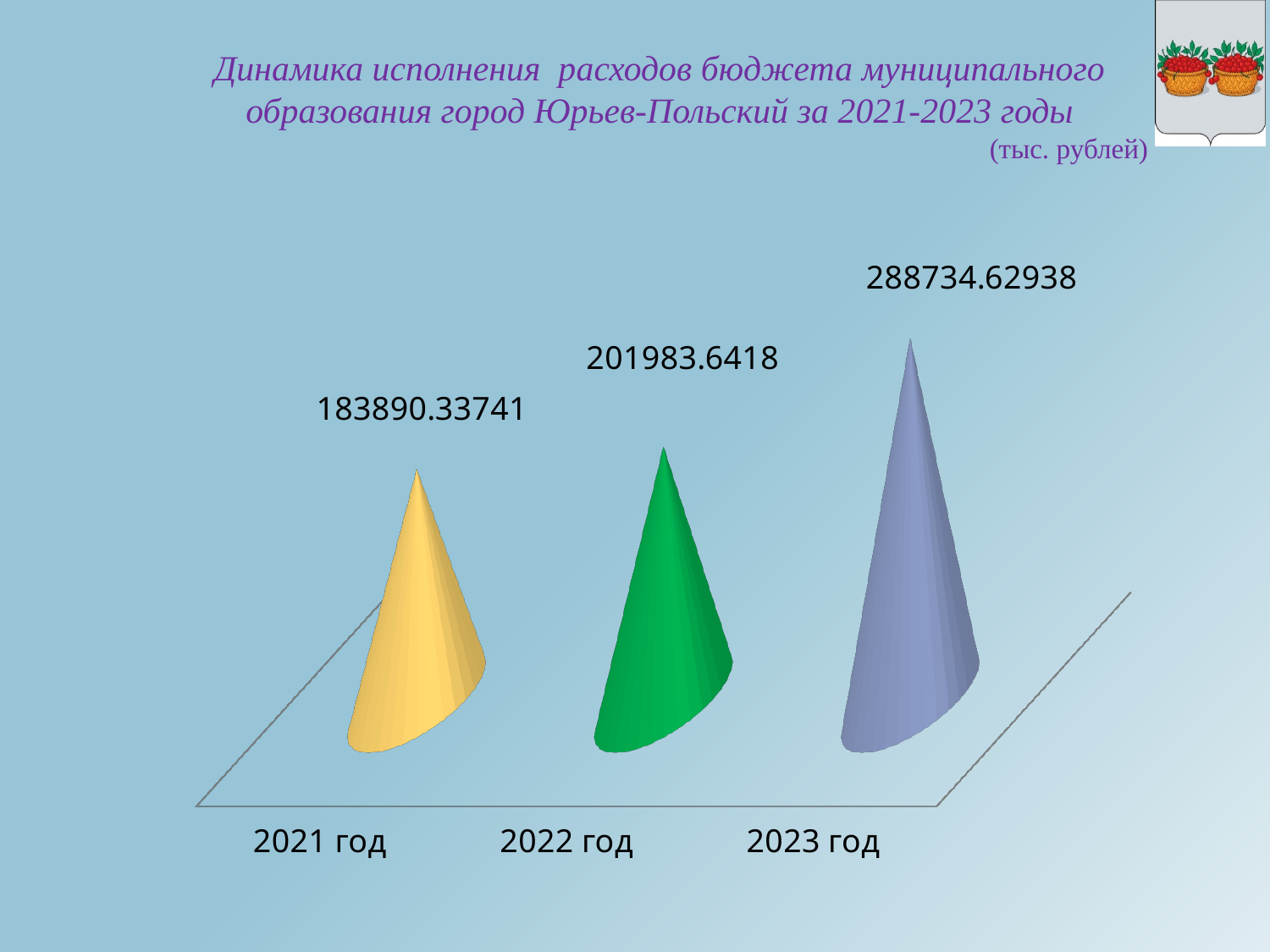
Do the values rise or fall from 2021 год to 2023 год? rise What is the value for 2021 год? 183890.33741 What is the value for 2022 год? 201983.6418 In what units are the values on the chart given? тыс. рублей What is the difference between the values for 2022 год and 2021 год? 18093.30439 What is the value for 2023 год? 288734.62938 Which is larger, the value for 2021 год or the value for 2022 год? 2022 год What is the difference between the values for 2023 год and 2022 год? 86750.98758 How many categories are shown on the chart? 3 Which year has the highest value? 2023 год What kind of chart is shown on the slide? bar chart Which year has the lowest value? 2021 год